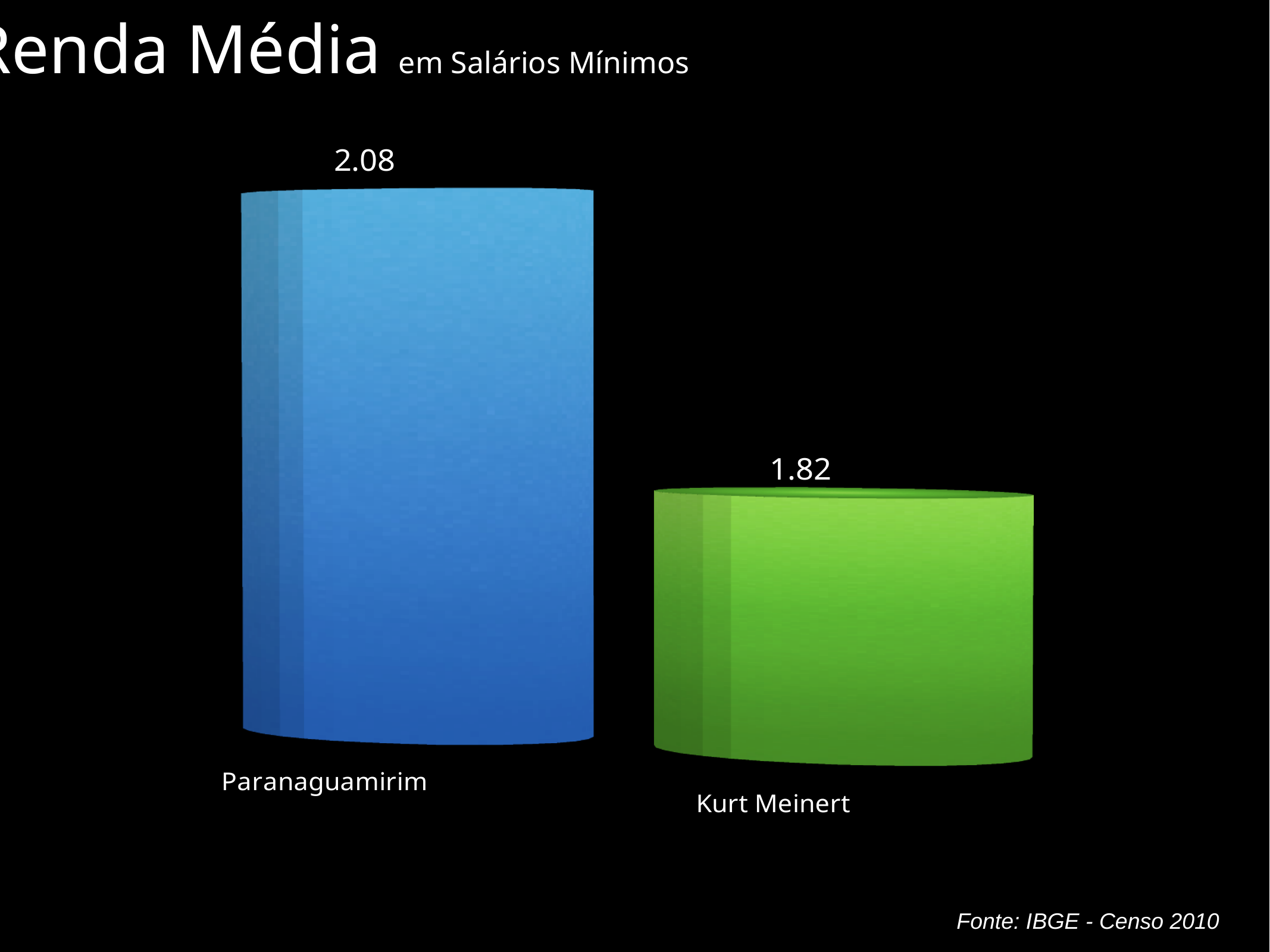
How many categories are shown in the chart? 2 What is the difference between the values for Paranaguamirim and Kurt Meinert? 0.26 What is the title of the chart? Renda Média em Salários Mínimos What colour is the bar for Kurt Meinert? green Which category has the lowest value? Kurt Meinert Which category has the highest value? Paranaguamirim What kind of chart is shown on the slide? bar chart Do the values rise or fall from left to right across the categories? fall What is the value for Paranaguamirim? 2.08 What is the value for Kurt Meinert? 1.82 Which is larger, the value for Paranaguamirim or the value for Kurt Meinert? Paranaguamirim